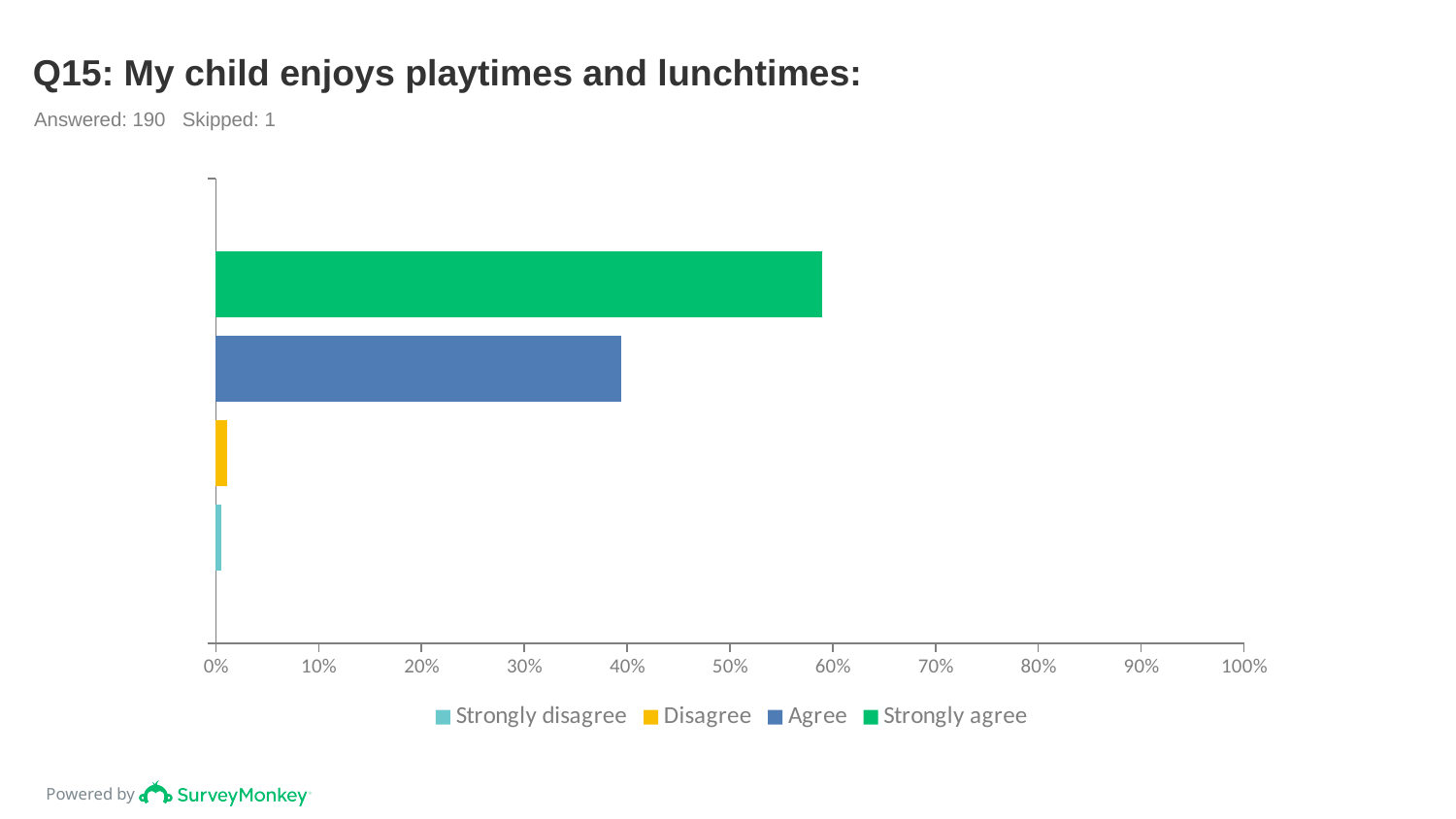
Is the value for Agree greater or less than 30%? greater Which response category has the highest value? Strongly agree Is the value for Strongly agree greater or less than 50%? greater Is the value for Strongly agree greater or less than 70%? less How many bars are plotted in the chart? 4 Which response category has the lowest value? Strongly disagree Which is larger, the value for Disagree or the value for Strongly disagree? Disagree What kind of chart is shown on the slide? bar chart Which is larger, the value for Strongly agree or the value for Agree? Strongly agree How many respondents answered this question according to the slide? 190 How many entries does the legend list? 4